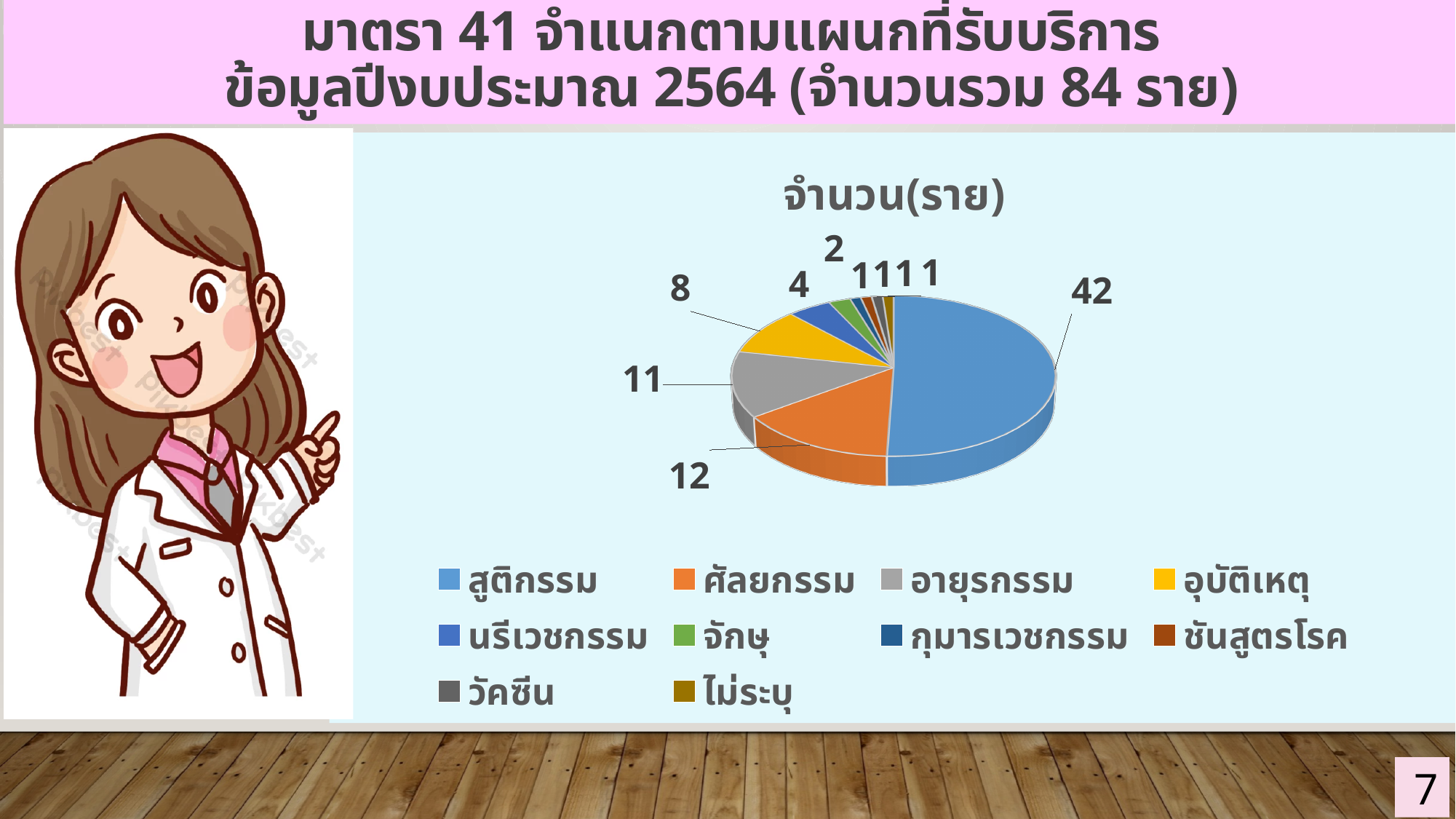
What is the value for อายุรกรรม? 11 What kind of chart is shown on the slide? pie chart What is the value for นรีเวชกรรม? 4 What is the value for อุบัติเหตุ? 8 Which category has the largest slice of the pie? สูติกรรม What is the difference between the values for สูติกรรม and ศัลยกรรม? 30 Which is larger, the value for อายุรกรรม or the value for อุบัติเหตุ? อายุรกรรม What is the title of the chart? จำนวน(ราย) What is the value for ศัลยกรรม? 12 What is the value for สูติกรรม? 42 What is the difference between the values for อุบัติเหตุ and นรีเวชกรรม? 4 How many categories does the legend of the pie chart list? 10